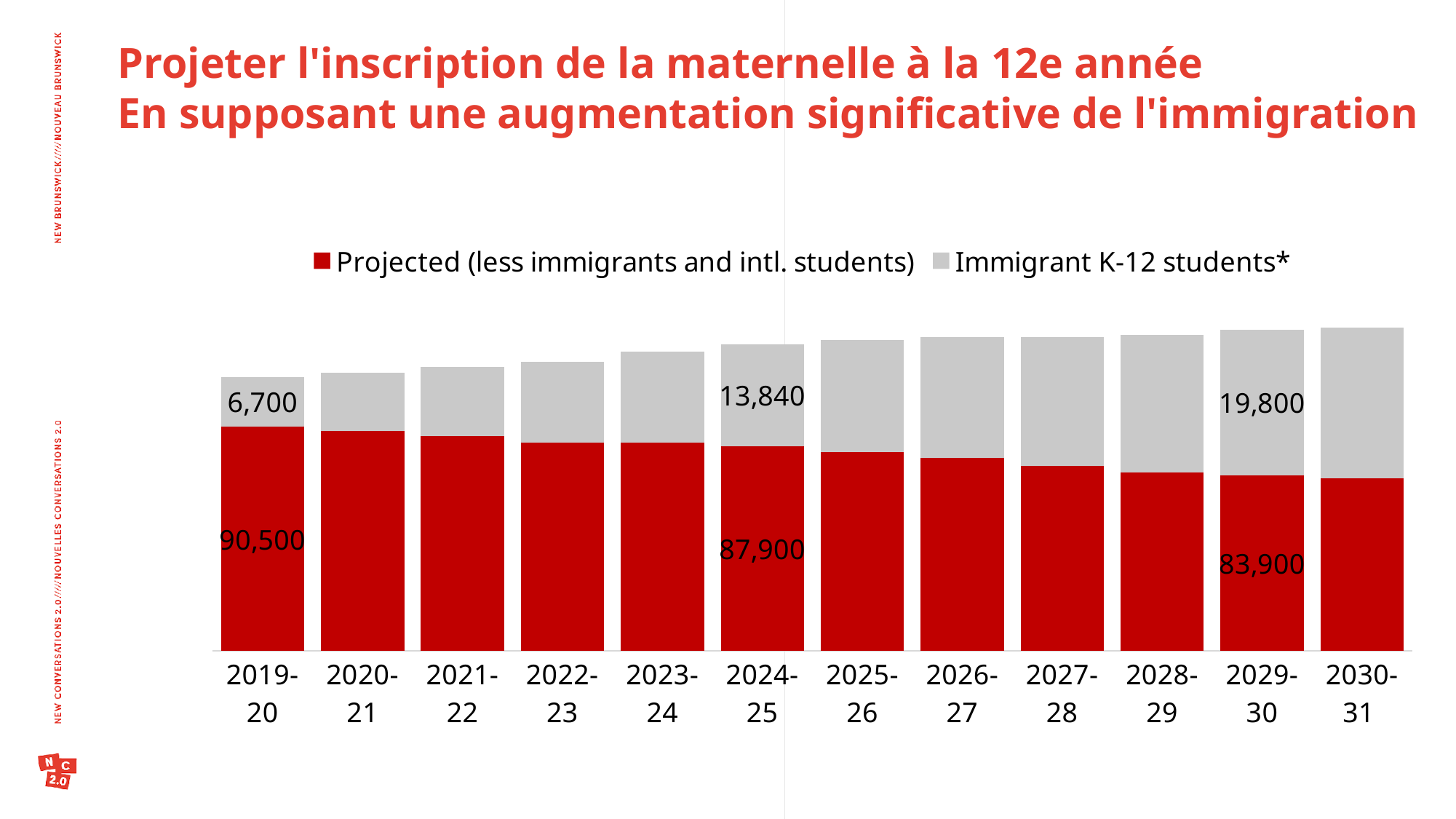
What type of chart is shown on the slide? Stacked bar chart What is the total of the stacked bar for 2019-20? 97,200 Which school year has the lowest value for Immigrant K-12 students*? 2019-20 Which is larger: Immigrant K-12 students* in 2019-20 or in 2029-30? 2029-30 What is the value of Immigrant K-12 students* for 2024-25? 13,840 Does the Projected (less immigrants and intl. students) series rise or fall from 2019-20 to 2030-31? Fall What is the value of Projected (less immigrants and intl. students) for 2019-20? 90,500 How many school years are shown on the x axis? 12 What is the value of Immigrant K-12 students* for 2029-30? 19,800 What is the difference between the Projected (less immigrants and intl. students) values for 2019-20 and 2029-30? 6,600 What is the total of the stacked bar for 2029-30? 103,700 How many series does the legend list? 2